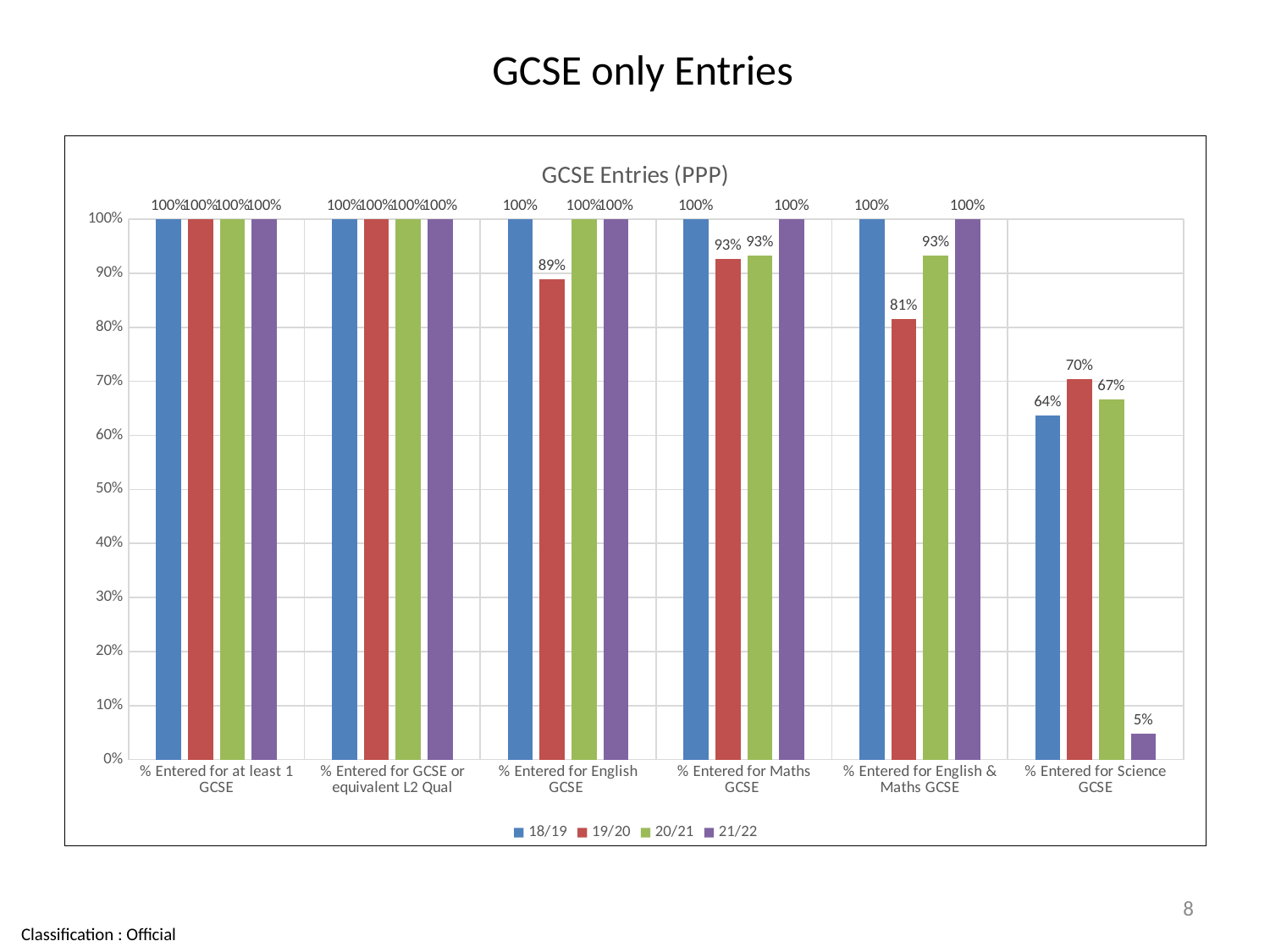
What kind of chart is shown? Bar chart Which series has the highest value in the % Entered for Science GCSE category? 19/20 What is the difference between the 19/20 and 21/22 values in the % Entered for Science GCSE category? 65% Which series has the lowest value in the % Entered for English & Maths GCSE category? 19/20 How many series does the legend list? 4 What is the value for 19/20 in the % Entered for English GCSE category? 89% How many categories are shown on the x axis? 6 What is the title of the chart? GCSE Entries (PPP) What is the value for 21/22 in the % Entered for Science GCSE category? 5% What is the value for 19/20 in the % Entered for English & Maths GCSE category? 81% Which is larger in the % Entered for Science GCSE category: the 18/19 value or the 20/21 value? 20/21 What is the value for 20/21 in the % Entered for Maths GCSE category? 93%